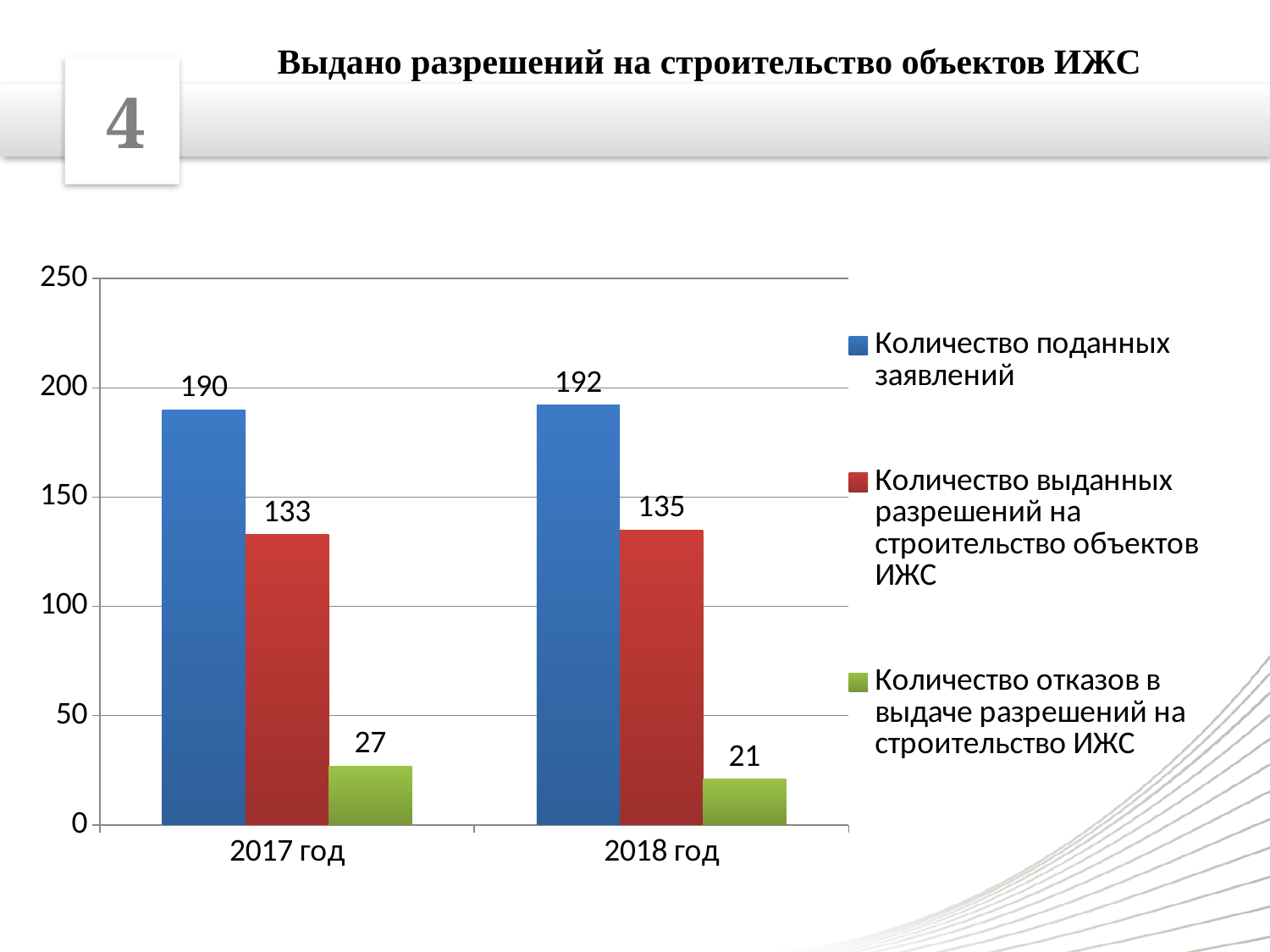
Which year has the lower value for "Количество отказов в выдаче разрешений на строительство ИЖС"? 2018 год By how much did "Количество отказов в выдаче разрешений на строительство ИЖС" change from 2017 год to 2018 год? 6 How many series does the legend list? 3 What is the title of the chart? Выдано разрешений на строительство объектов ИЖС What is the value of "Количество отказов в выдаче разрешений на строительство ИЖС" for 2018 год? 21 What is the value of "Количество отказов в выдаче разрешений на строительство ИЖС" for 2017 год? 27 What is the difference between "Количество поданных заявлений" and "Количество выданных разрешений на строительство объектов ИЖС" in 2017 год? 57 What is the value of "Количество выданных разрешений на строительство объектов ИЖС" for 2018 год? 135 Which year has the higher value for "Количество поданных заявлений"? 2018 год Is the value for "Количество выданных разрешений на строительство объектов ИЖС" in 2017 год greater or less than 150? less What is the value of "Количество поданных заявлений" for 2017 год? 190 What kind of chart is shown on the slide? bar chart